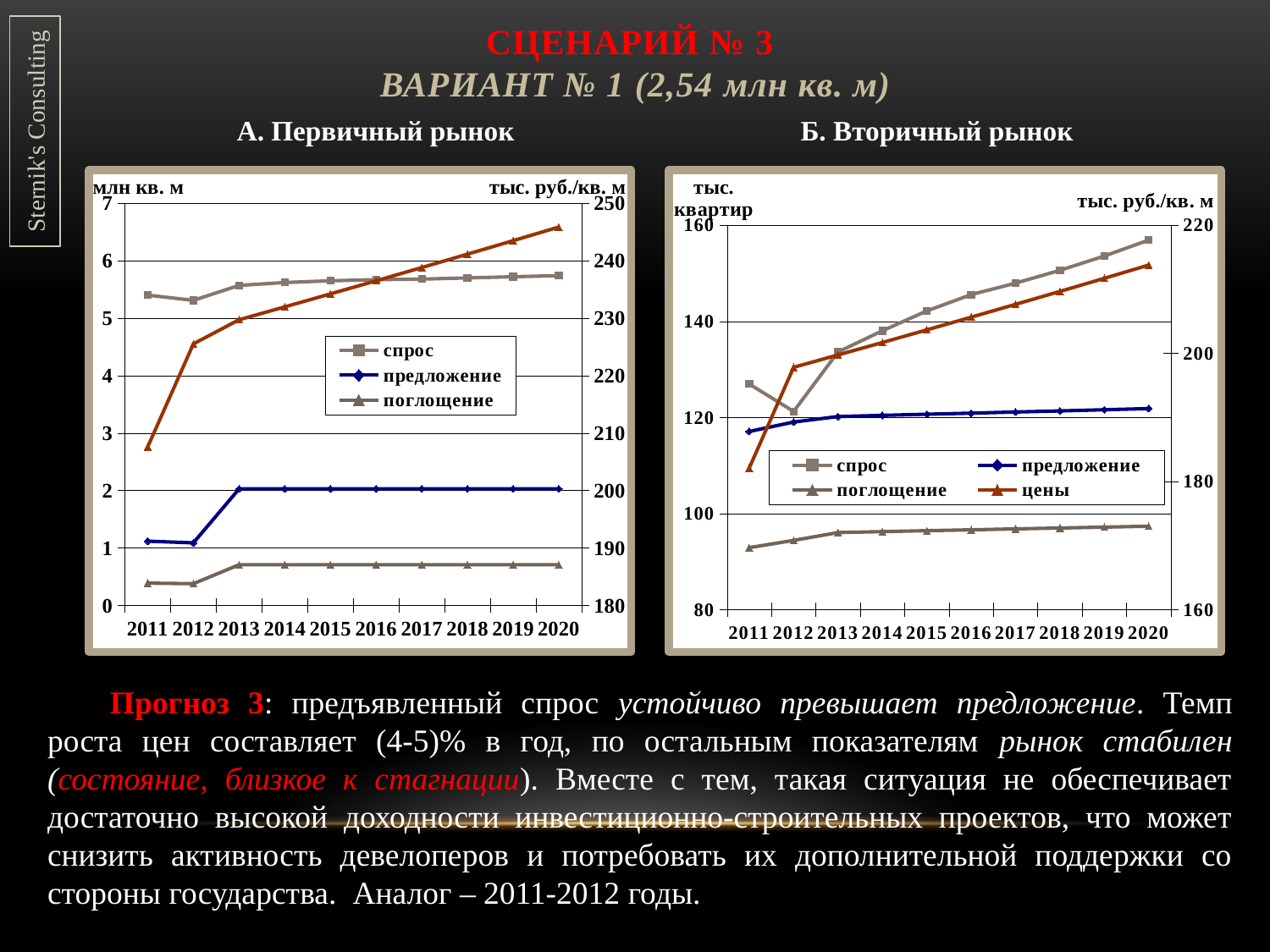
In the 'А. Первичный рынок' chart, which series has the lowest value in 2020? поглощение What kind of chart is shown under 'А. Первичный рынок'? line chart In the 'А. Первичный рынок' chart, how many years are shown on the x axis? 10 In the 'А. Первичный рынок' chart, is the value for поглощение in 2020 greater or less than 1? less In the 'А. Первичный рынок' chart, is the value for спрос in 2011 greater or less than 5? greater In the 'Б. Вторичный рынок' chart, is the value for поглощение in 2015 greater or less than 100? less In the 'Б. Вторичный рынок' chart, which is larger in 2018: спрос or предложение? спрос How many series does the legend of the 'А. Первичный рынок' chart list? 3 How many series does the legend of the 'Б. Вторичный рынок' chart list? 4 What is the title of the left chart on the slide? А. Первичный рынок In the 'Б. Вторичный рынок' chart, does the цены line rise or fall from 2011 to 2020? rises